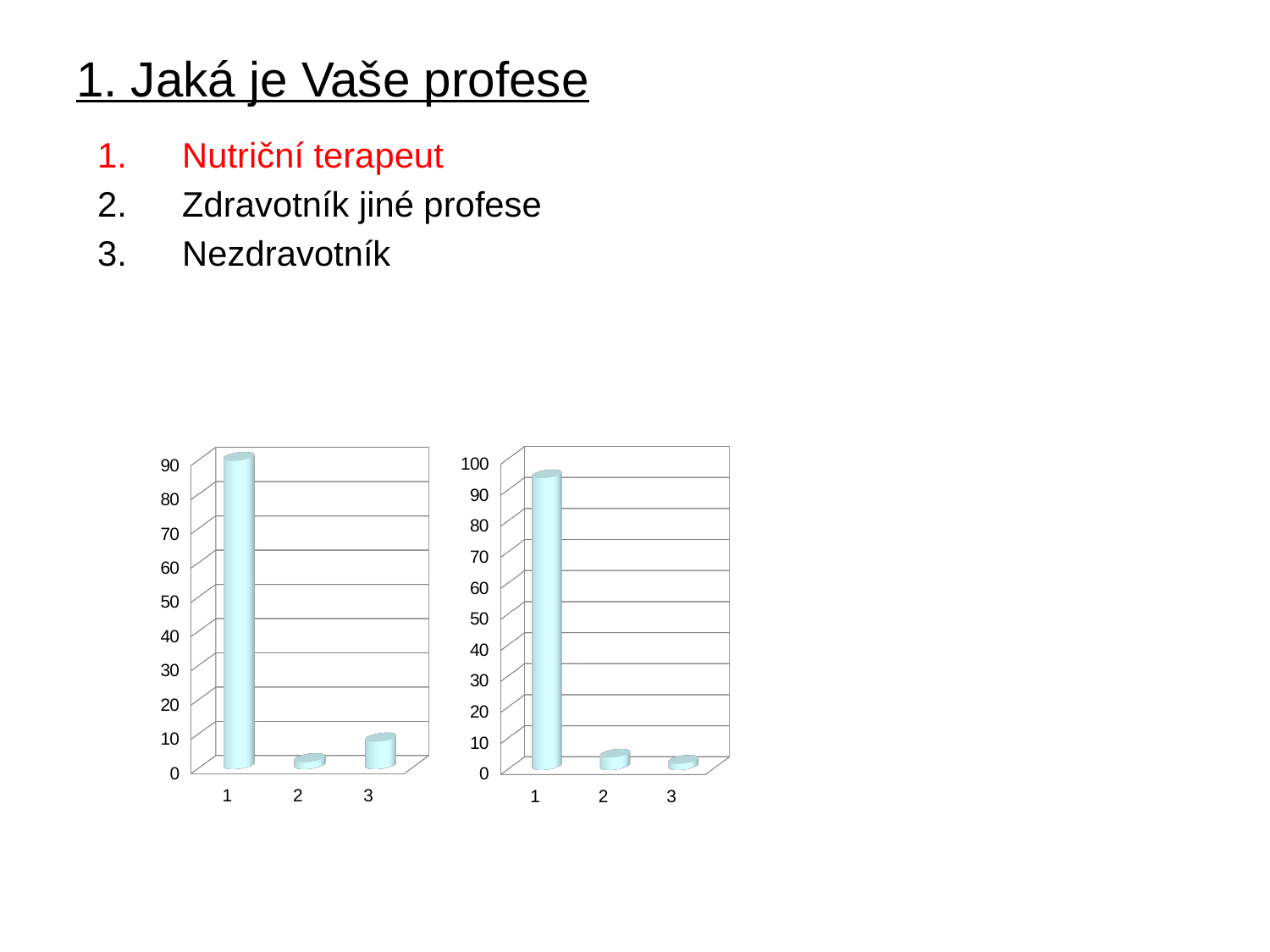
In the chart on the left of the slide, which is larger, the value for category 2 or category 3? 3 How many categories does the chart on the right of the slide show? 3 In the chart on the right of the slide, is the value for category 1 greater or less than 90? greater In the chart on the left of the slide, is the value for category 1 greater or less than 80? greater In the chart on the right of the slide, which category has the highest value? 1 What kind of chart is the chart on the left of the slide? bar chart In the chart on the left of the slide, which category has the highest value? 1 In the chart on the left of the slide, which category has the lowest value? 2 In the chart on the right of the slide, is the value for category 2 greater or less than 10? less In the chart on the right of the slide, which category has the lowest value? 3 What is the highest value shown on the vertical axis of the chart on the right of the slide? 100